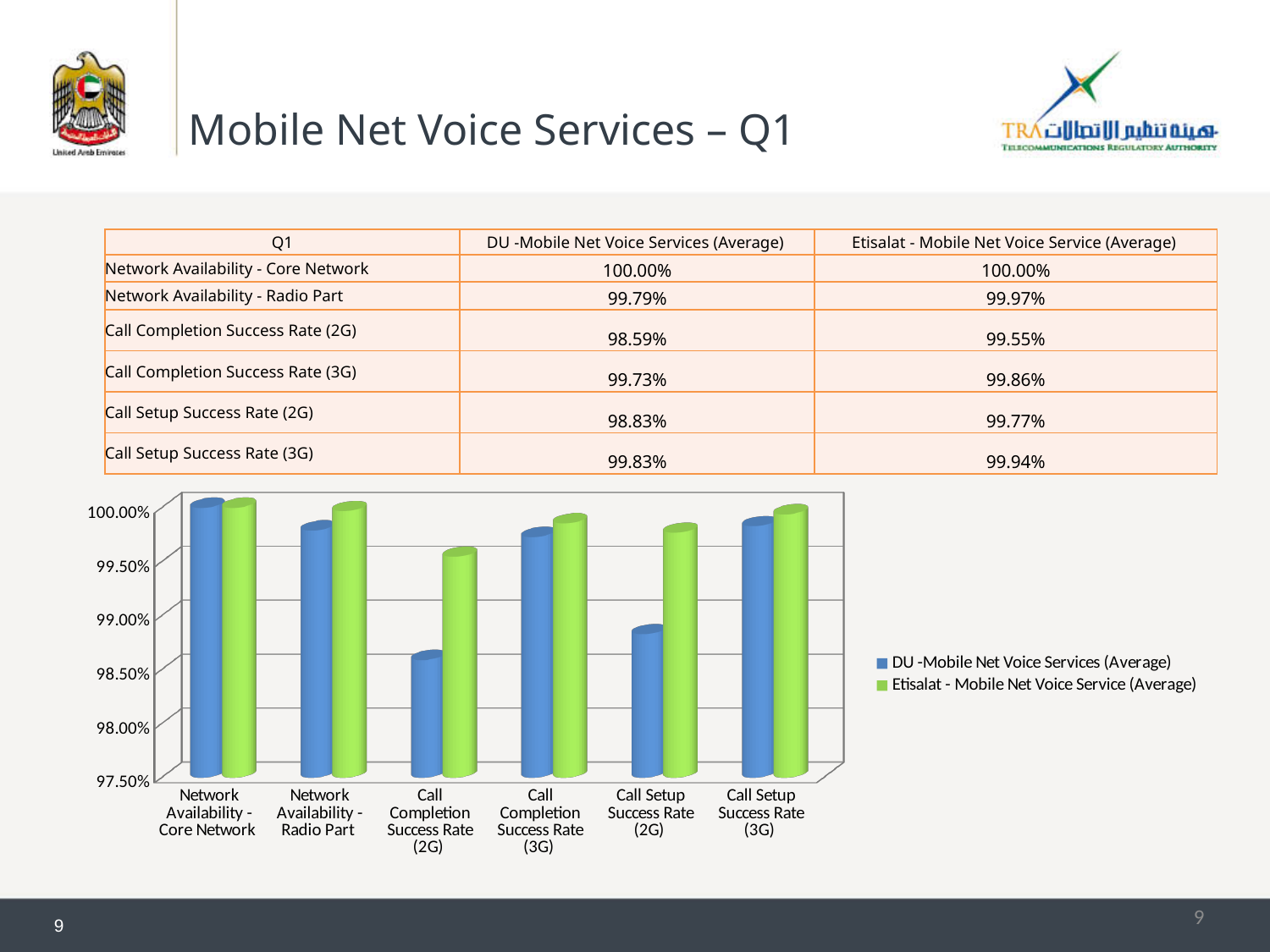
What is the DU value for Network Availability - Radio Part? 99.79% What kind of chart is shown on the slide? bar chart For Call Completion Success Rate (2G), which is larger, the DU value or the Etisalat value? Etisalat Which category has the lowest DU value? Call Completion Success Rate (2G) Is the DU value for Call Setup Success Rate (2G) greater or less than 99.00%? less How many categories are shown along the x axis of the chart? 6 What is the difference between the Etisalat and DU values for Call Setup Success Rate (2G)? 0.94% What is the Etisalat value for Call Setup Success Rate (3G)? 99.94% How many series does the chart legend list? 2 What is the DU value for Call Completion Success Rate (2G)? 98.59% Is the Etisalat value for Call Completion Success Rate (2G) greater or less than 99.50%? greater Which category has the lowest Etisalat value? Call Completion Success Rate (2G)